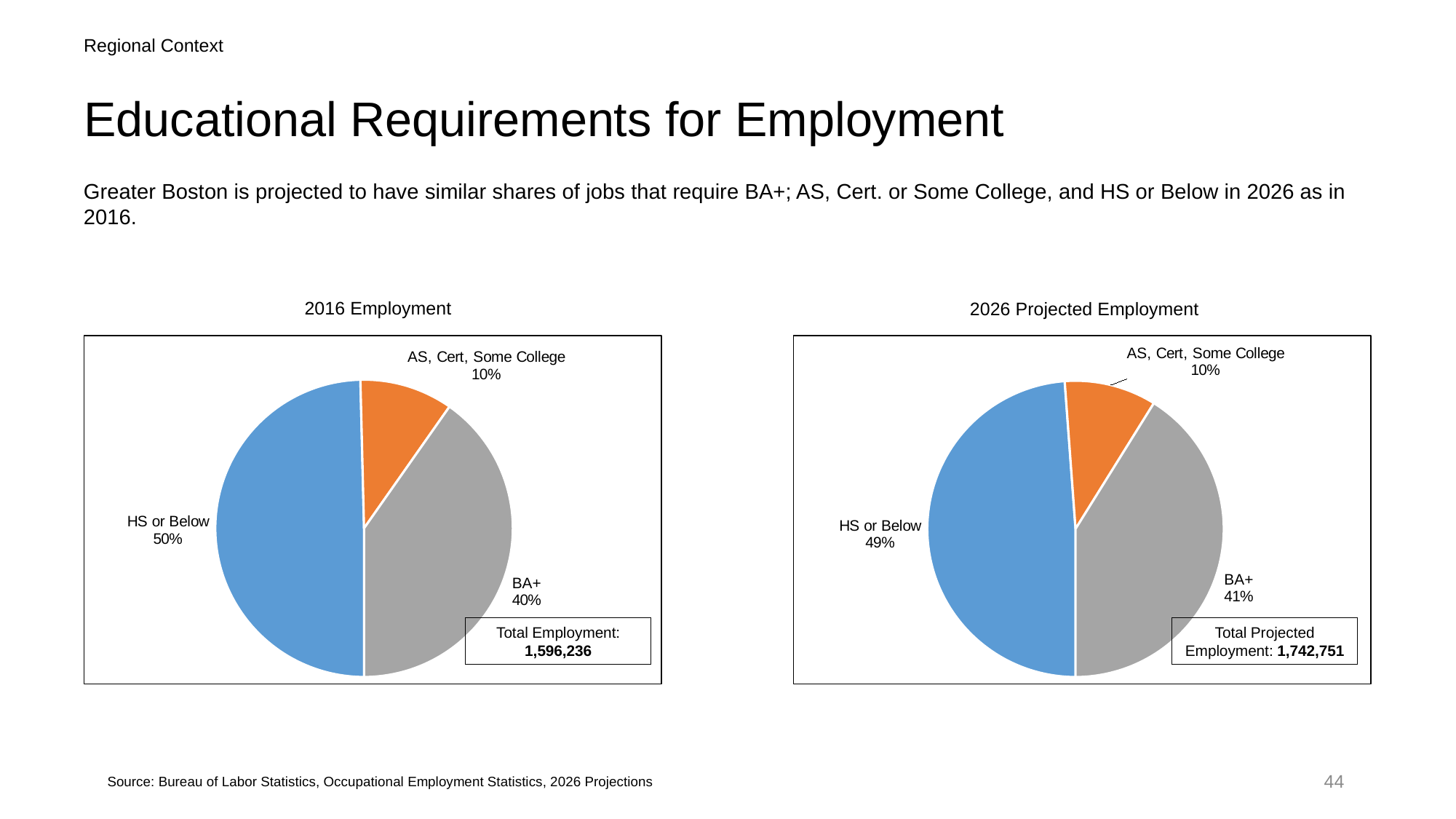
What is the total employment shown in the 2016 Employment chart? 1,596,236 In the 2016 Employment chart, which category has the smallest share? AS, Cert, Some College How many categories are shown in the 2016 Employment pie chart? 3 In the 2016 Employment chart, what share of jobs require HS or Below? 50% In the 2026 Projected Employment chart, which is larger: the share for BA+ or the share for AS, Cert, Some College? BA+ What type of chart is the 2026 Projected Employment chart? Pie chart In the 2016 Employment chart, what colour is the HS or Below slice? Blue In the 2016 Employment chart, what is the difference in percentage points between the HS or Below share and the BA+ share? 10 What is the total projected employment shown in the 2026 Projected Employment chart? 1,742,751 In the 2026 Projected Employment chart, which category has the largest share? HS or Below In the 2016 Employment chart, what share of jobs require AS, Cert, Some College? 10% In the 2026 Projected Employment chart, what share of jobs require BA+? 41%